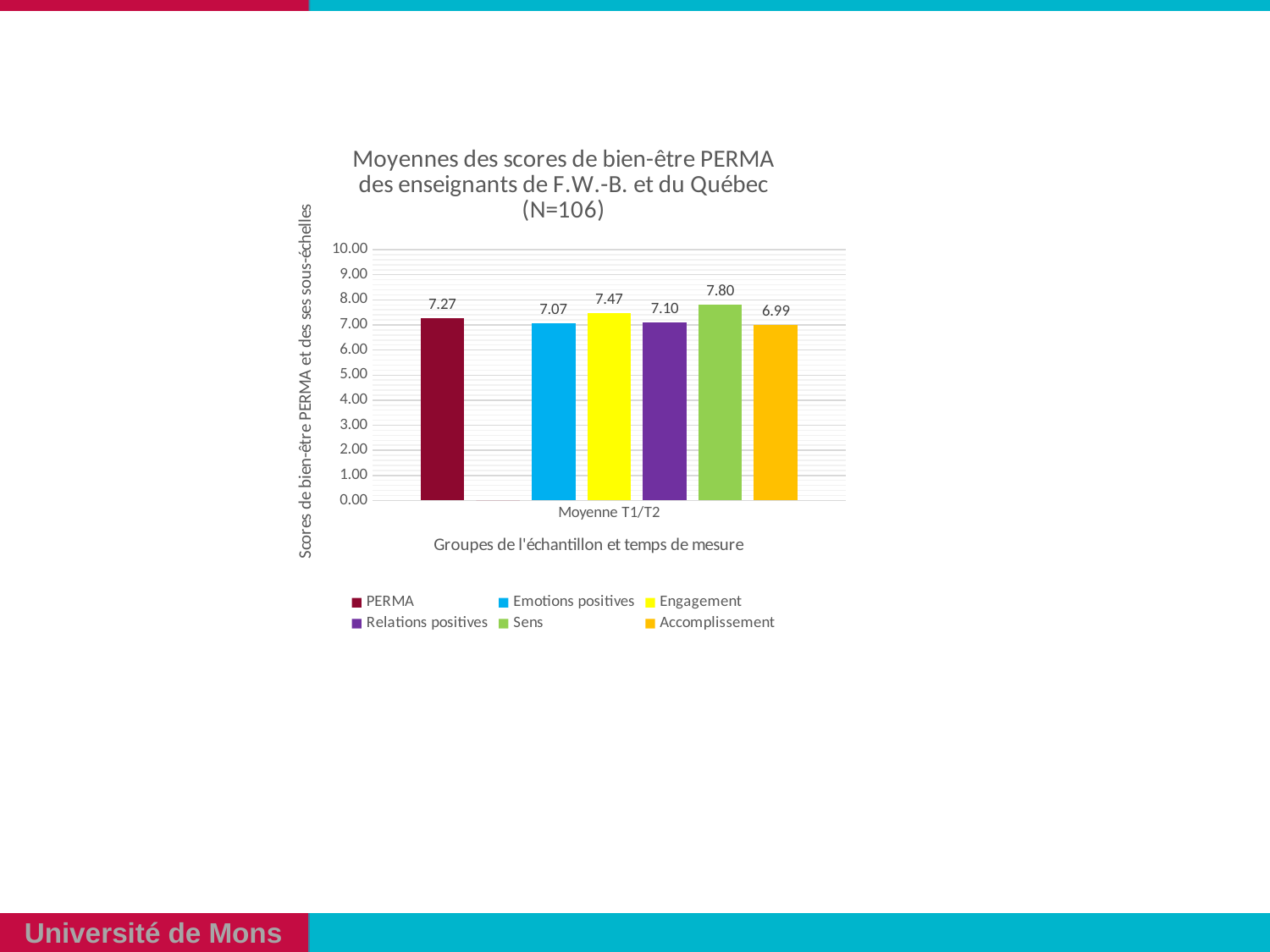
Which is larger, the value for PERMA or the value for Relations positives? PERMA Which series has the lowest value? Accomplissement Which series has the highest value? Sens What kind of chart is shown on the slide? Bar chart What is the value for Accomplissement? 6.99 What is the value for PERMA? 7.27 What is the label of the category on the x axis? Moyenne T1/T2 What is the value for Engagement? 7.47 How many series does the legend list? 6 What is the value for Sens? 7.80 What is the difference between the values for Engagement and Emotions positives? 0.40 What is the difference between the values for Sens and Accomplissement? 0.81